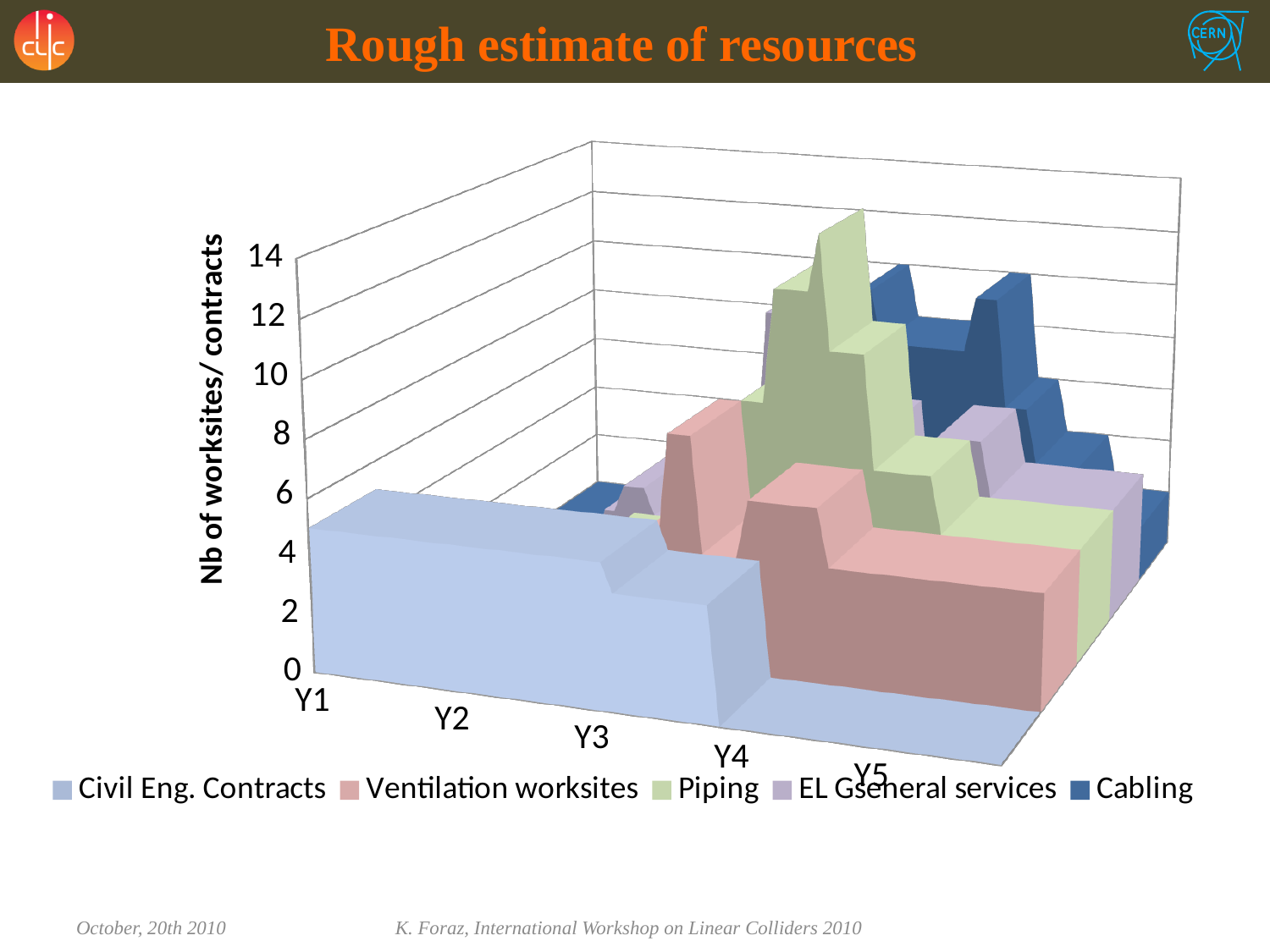
What is the maximum value shown on the vertical axis? 14 Is the value for Civil Eng. Contracts at Y1 greater or less than 2? greater Is the value for Civil Eng. Contracts at Y1 greater or less than 8? less How many categories are shown on the x axis? 5 How many series does the legend list? 5 Which series is shown in dark blue? Cabling What kind of chart is shown on the slide? 3D area chart What is the label of the first category on the x axis? Y1 What is the label of the last category on the x axis? Y5 Does the Civil Eng. Contracts series rise or fall overall from Y1 to Y5? fall What is the title of the vertical axis? Nb of worksites/ contracts Which series is listed first in the legend? Civil Eng. Contracts